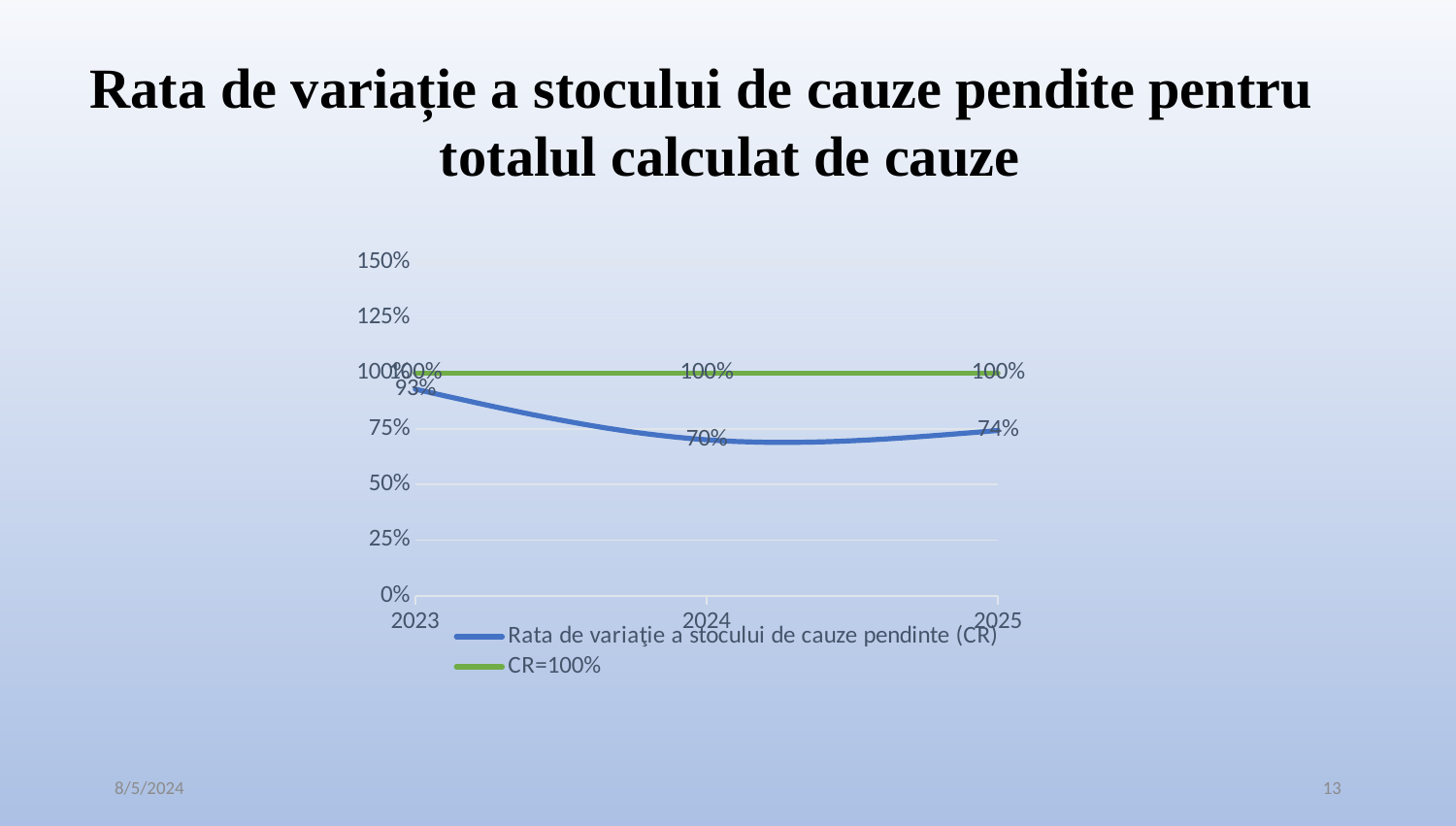
What is the value of 'Rata de variaţie a stocului de cauze pendinte (CR)' in 2024? 70% What is the value of 'Rata de variaţie a stocului de cauze pendinte (CR)' in 2025? 74% Is the CR value for 2023 greater or less than 75%? greater In which year is 'Rata de variaţie a stocului de cauze pendinte (CR)' lowest? 2024 How many years are plotted along the x axis? 3 What colour is the 'CR=100%' line? green Does the CR line rise or fall from 2023 to 2024? fall How many series does the legend list? 2 What kind of chart is shown on the slide? line chart What is the difference between the CR values for 2025 and 2024? 4% What is the value of the 'CR=100%' series in 2024? 100% Which year has the larger CR value, 2024 or 2025? 2025